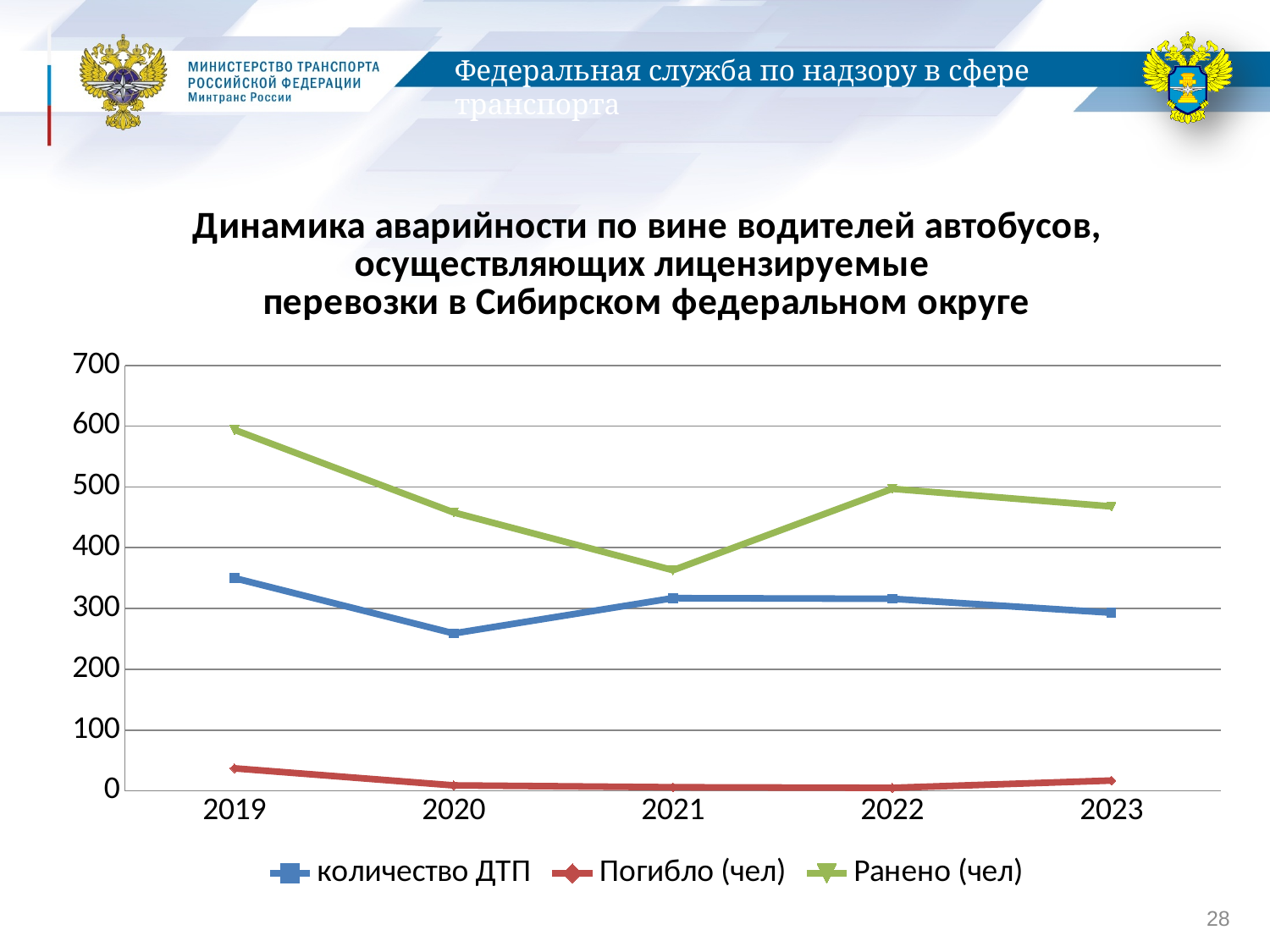
How many years are plotted along the x axis? 5 In which year is the value for количество ДТП lowest? 2020 Is the value for Ранено (чел) in 2019 greater or less than 500? greater How many series does the legend list? 3 In which year is the value for Ранено (чел) lowest? 2021 What kind of chart is shown on the slide? line chart Is the value for Ранено (чел) in 2021 greater or less than 400? less In which year is the value for Погибло (чел) highest? 2019 Does the value for Ранено (чел) rise or fall from 2019 to 2021? fall Which is larger in 2022: the value for Ранено (чел) or the value for количество ДТП? Ранено (чел) In which year is the value for Ранено (чел) highest? 2019 Is the value for количество ДТП in 2020 greater or less than 300? less